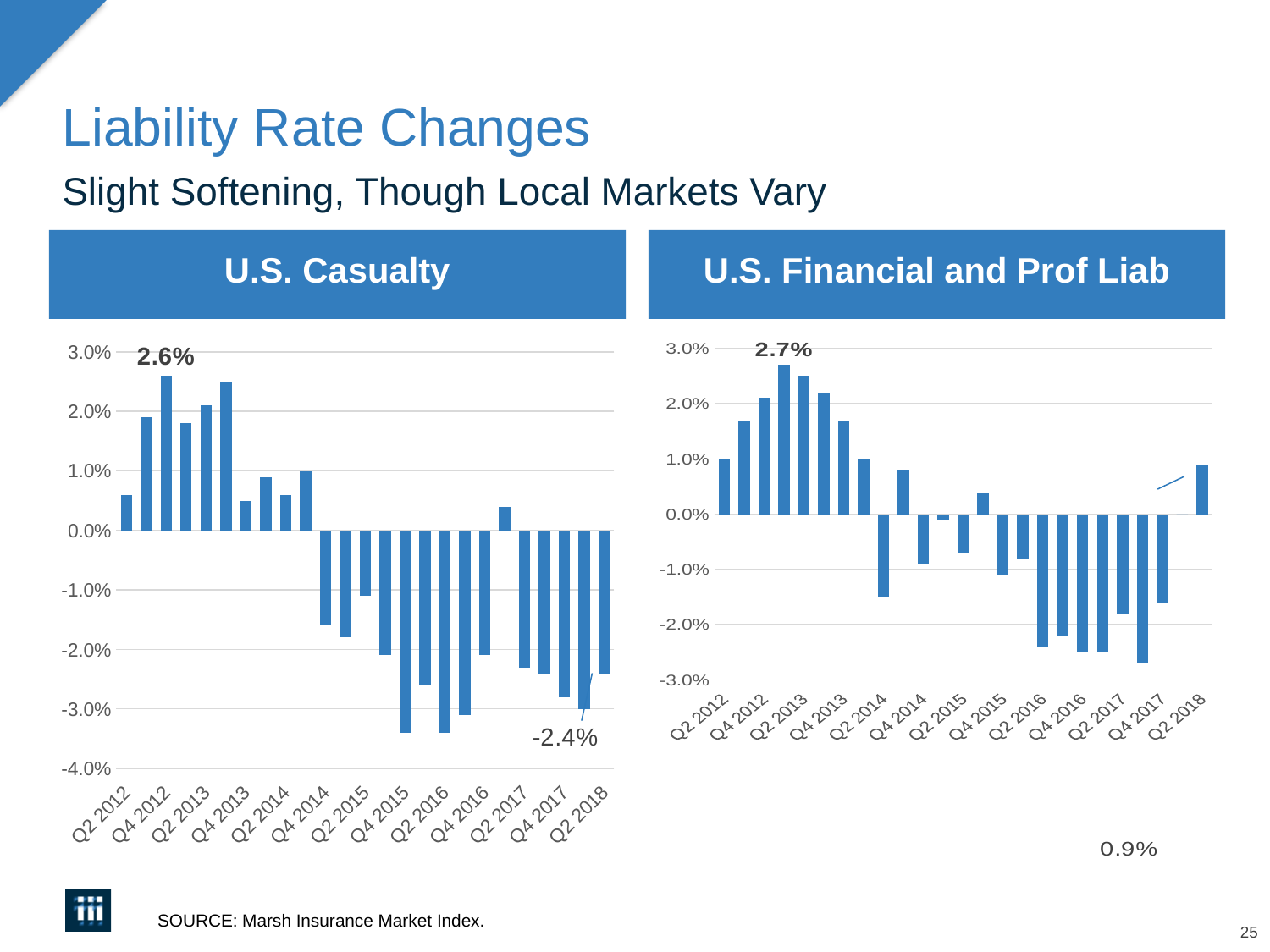
In the U.S. Casualty chart, what is the highest labeled rate change? 2.6% In the U.S. Casualty chart, is the value for Q2 2012 greater or less than 1.0%? less In the U.S. Casualty chart, what is the difference between the peak value of 2.6% and the Q2 2018 value of -2.4%? 5.0 percentage points In the U.S. Financial and Prof Liab chart, what is the rate change for Q2 2018? 0.9% In the U.S. Casualty chart, what is the rate change for Q2 2018? -2.4% Which chart has the higher Q2 2018 value, U.S. Casualty or U.S. Financial and Prof Liab? U.S. Financial and Prof Liab In the U.S. Financial and Prof Liab chart, is the value for Q2 2012 greater or less than 2.0%? less In the U.S. Financial and Prof Liab chart, what is the highest labeled rate change? 2.7% What type of chart is used for U.S. Casualty? Bar chart What is the source cited for the charts on the slide? Marsh Insurance Market Index In the U.S. Casualty chart, do the rate changes generally rise or fall from Q2 2012 to Q2 2018? fall In the U.S. Financial and Prof Liab chart, what is the difference between the peak value of 2.7% and the Q2 2018 value of 0.9%? 1.8 percentage points